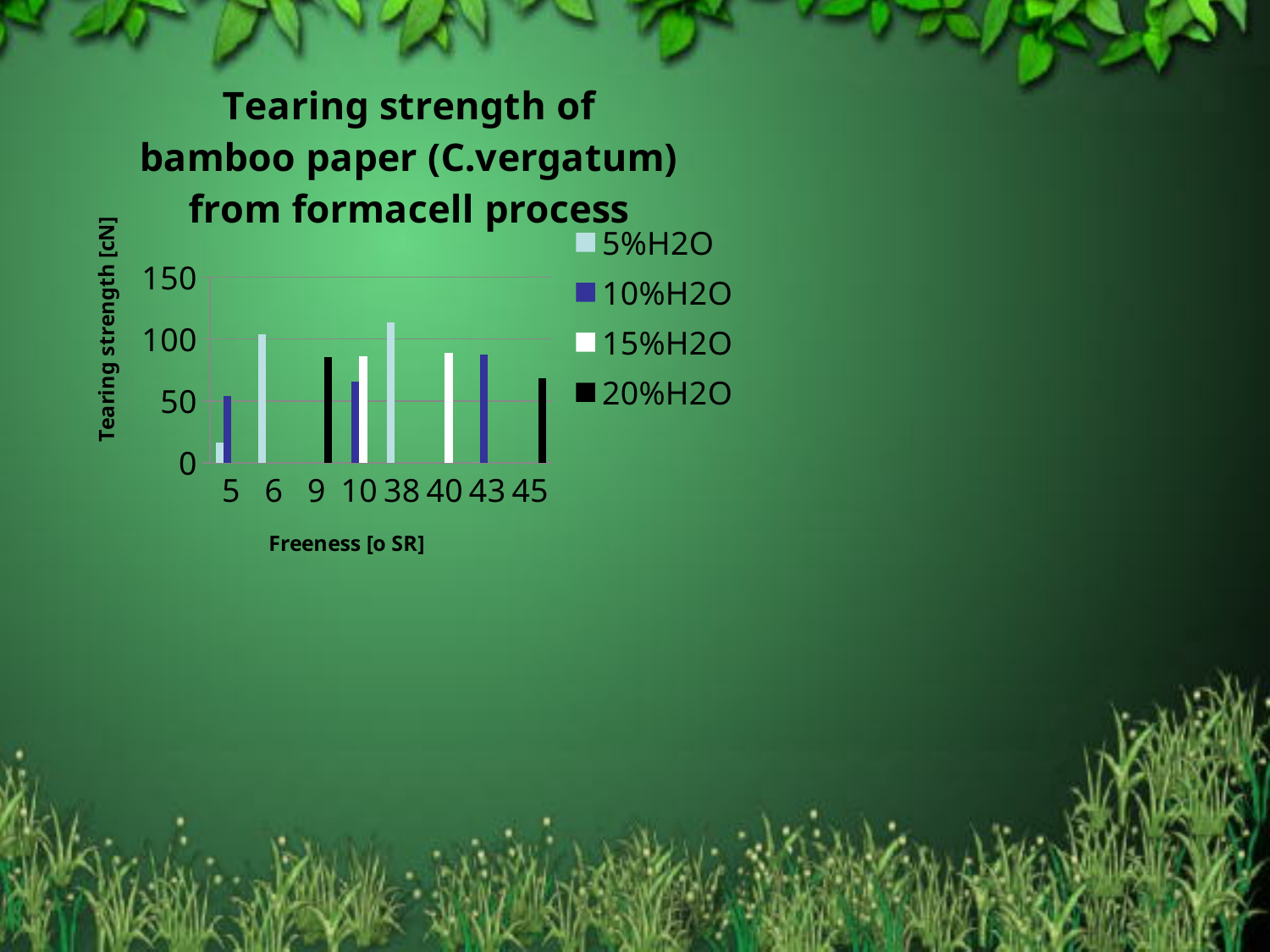
What kind of chart is shown on the slide? bar chart How many series does the legend list? 4 Is the 10%H2O value at freeness 5 greater or less than 100? less What is the title of the vertical axis? Tearing strength [cN] Which bar is the lowest in the chart? 5%H2O at freeness 5 At freeness 10, which is larger: the 10%H2O value or the 15%H2O value? 15%H2O Is the 20%H2O value at freeness 45 greater or less than 100? less Is the 5%H2O value at freeness 38 greater or less than 100? greater What is the title of the horizontal axis? Freeness [o SR] How many freeness categories are shown on the x axis? 8